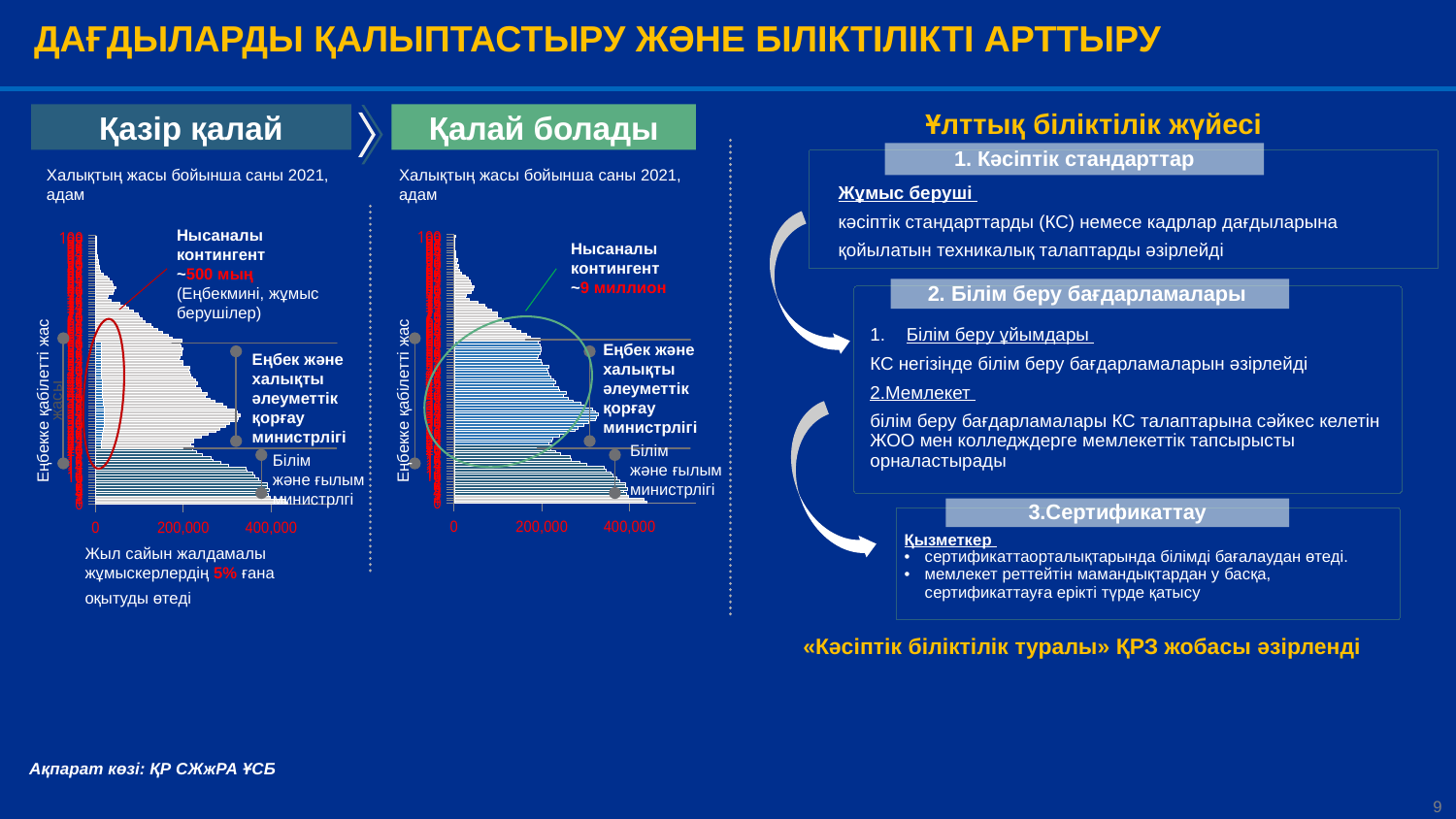
In the chart under the "Қалай болады" heading, is the value of the longest bar greater or less than 400,000? greater What is the y-axis label of the chart under the "Қалай болады" heading? Еңбекке қабілетті жас In the chart under the "Қазір қалай" heading, is the value of the longest bar greater or less than 400,000? greater What is the title of the chart under the "Қазір қалай" heading? Халықтың жасы бойынша саны 2021, адам What kind of chart is the chart under the "Қалай болады" heading in the middle? bar chart In the chart under the "Қазір қалай" heading, is the value of the longest bar greater or less than 200,000? greater What kind of chart is the chart under the "Қазір қалай" heading on the left? bar chart